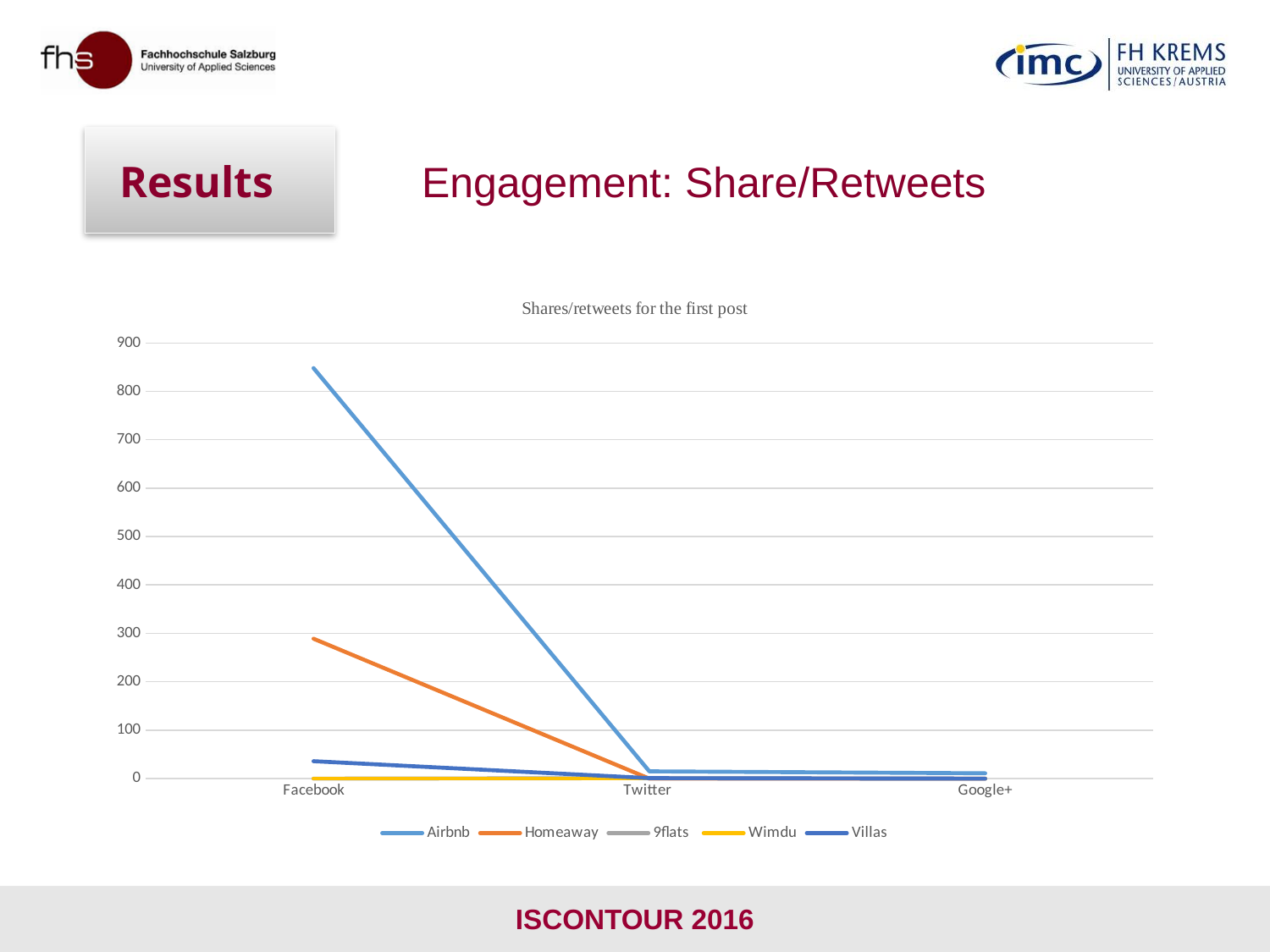
Which series is drawn in orange in the legend? Homeaway Which series has the highest value for Facebook? Airbnb Is the value for Homeaway at Facebook greater or less than 200? greater Is the value for Airbnb at Twitter greater or less than 100? less How many series does the legend list? 5 Which is larger at Facebook, the value for Airbnb or the value for Homeaway? Airbnb Is the value for Airbnb at Facebook greater or less than 800? greater How many categories are shown on the x axis? 3 What is the title of the chart? Shares/retweets for the first post Which is larger at Facebook, the value for Villas or the value for Homeaway? Homeaway What kind of chart is shown on the slide? line chart Does the Airbnb line rise or fall from Facebook to Twitter? fall